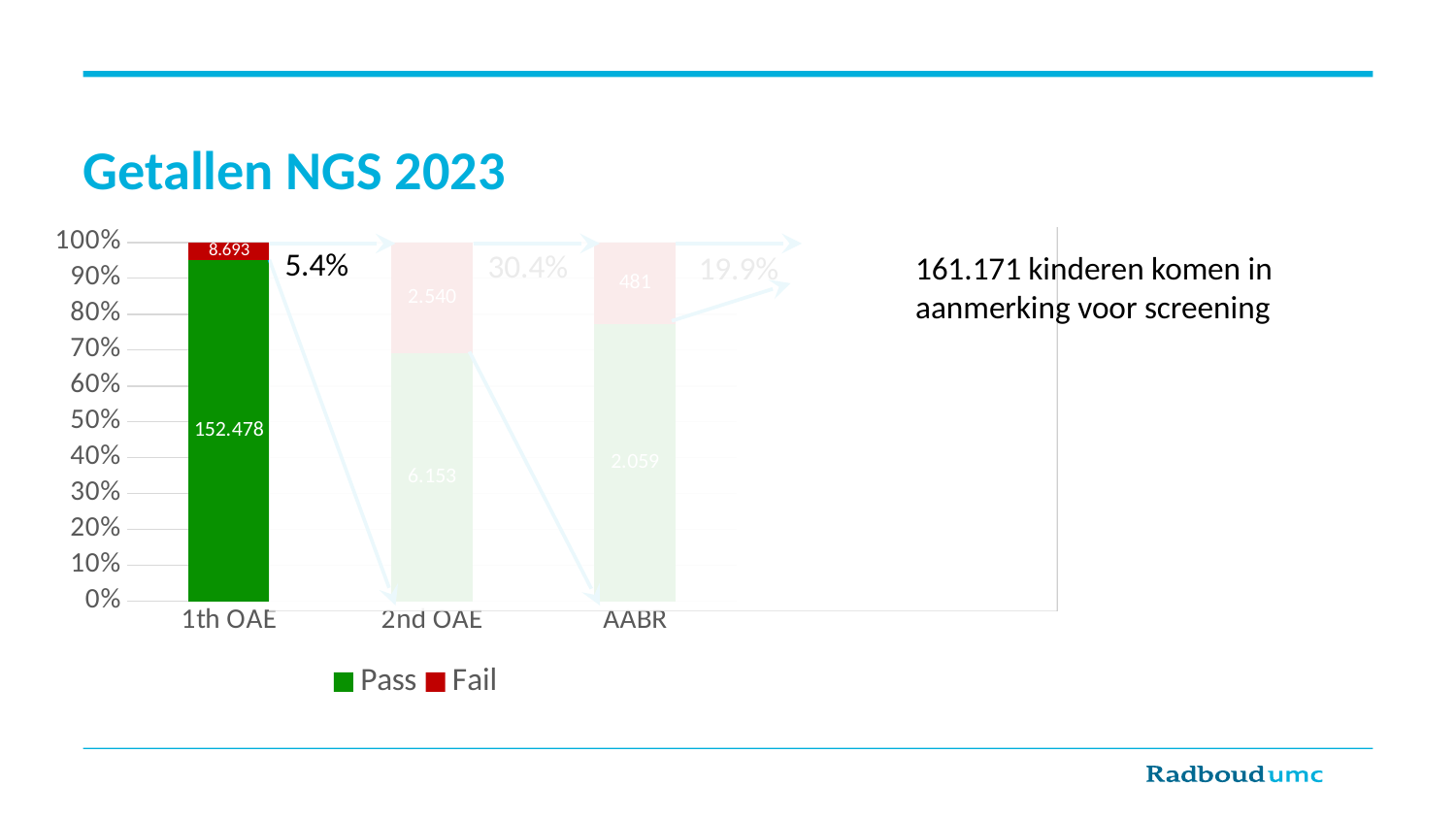
What is the title of the chart on the slide? Getallen NGS 2023 Which is larger for 1th OAE, the Pass value or the Fail value? Pass What type of chart is shown on the slide? stacked bar chart How many series does the legend list? 2 Is the Pass share of the 1th OAE bar greater or less than 90%? greater What is the Fail value for 1th OAE? 8.693 How many categories are shown on the x axis? 3 What is the Pass value for 1th OAE? 152.478 Which category has the highest Pass value? 1th OAE What is the total of the 1th OAE bar (Pass plus Fail)? 161.171 What percentage is annotated next to the 1th OAE bar? 5.4% What is the difference between the Pass and Fail values for 1th OAE? 143.785